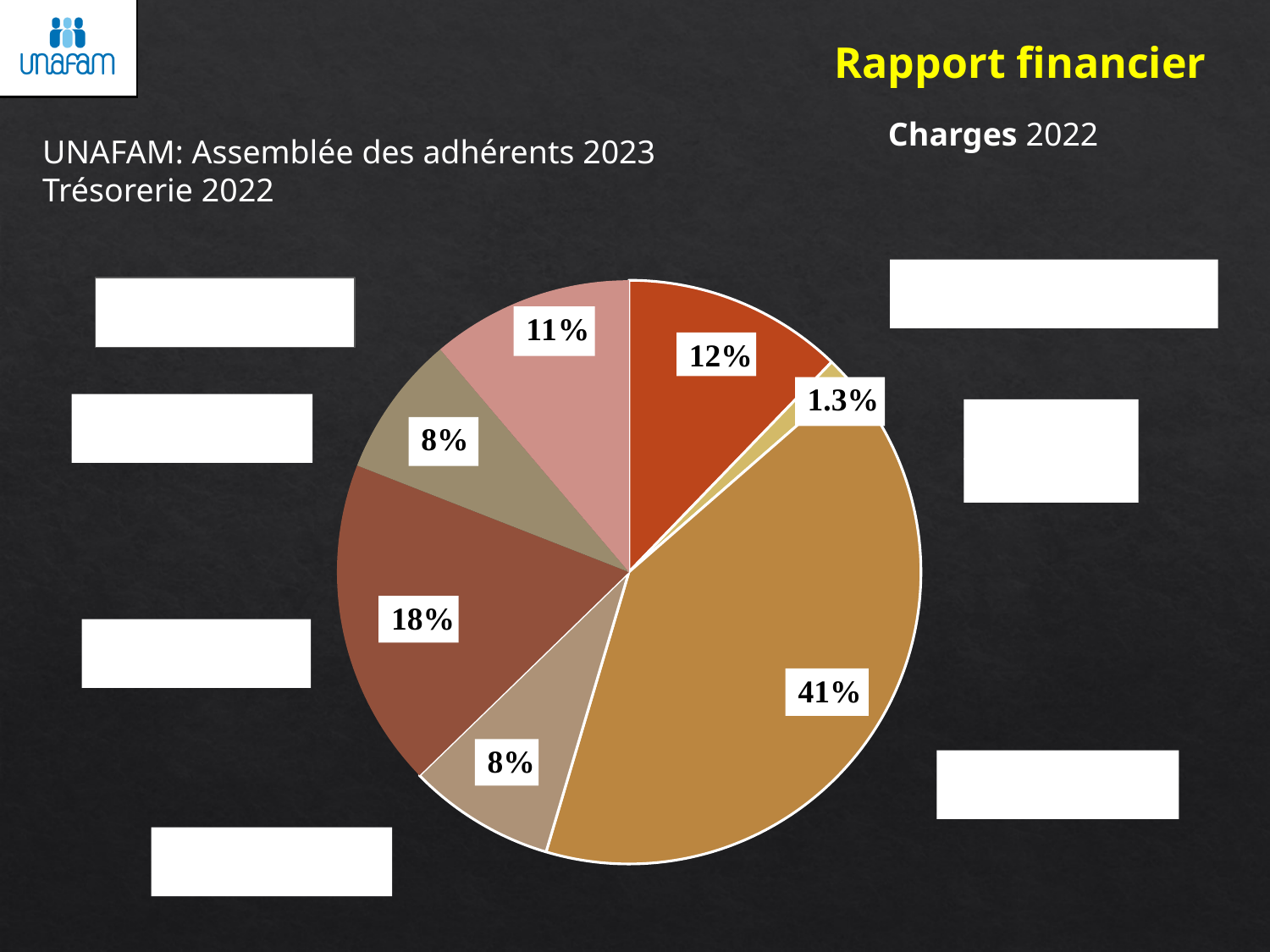
How many slices does the pie chart have? 7 Which year do the charges shown in the pie chart refer to? 2022 What percentage is shown on the dark red-orange slice at the top of the pie chart? 12% Which is larger, the light pink slice or the olive-green slice? the light pink slice (11%) What is the percentage of the smallest slice in the pie chart? 1.3% Does the largest slice of the pie account for more or less than half of the pie? less What is the percentage of the largest slice in the pie chart? 41% How many slices of the pie chart are labelled 8%? 2 What is the difference in percentage points between the largest slice (41%) and the dark brown slice (18%)? 23 What percentage is shown on the dark brown slice on the left of the pie chart? 18% What kind of chart is shown on the slide? pie chart What percentage is shown on the light pink slice of the pie chart? 11%